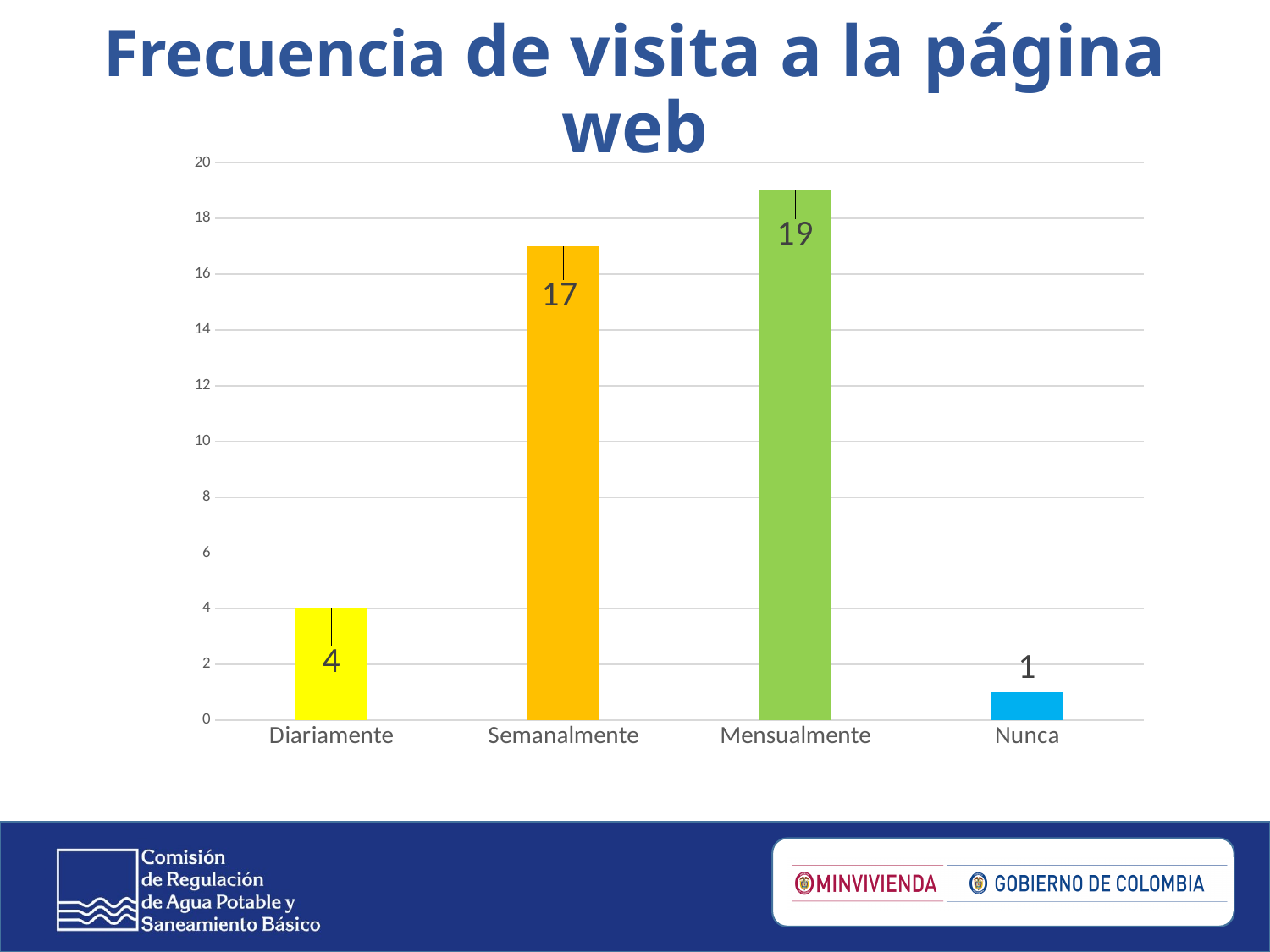
How many categories are shown on the x axis? 4 Is the value for Mensualmente greater or less than 18? greater What kind of chart is shown on the slide? bar chart What is the value for Nunca? 1 What is the title of the chart? Frecuencia de visita a la página web Which category has the lowest value? Nunca What is the value for Semanalmente? 17 Which is larger, the value for Diariamente or the value for Semanalmente? Semanalmente Which category has the highest value? Mensualmente What is the difference between the values for Mensualmente and Semanalmente? 2 What is the difference between the values for Diariamente and Nunca? 3 What is the value for Diariamente? 4